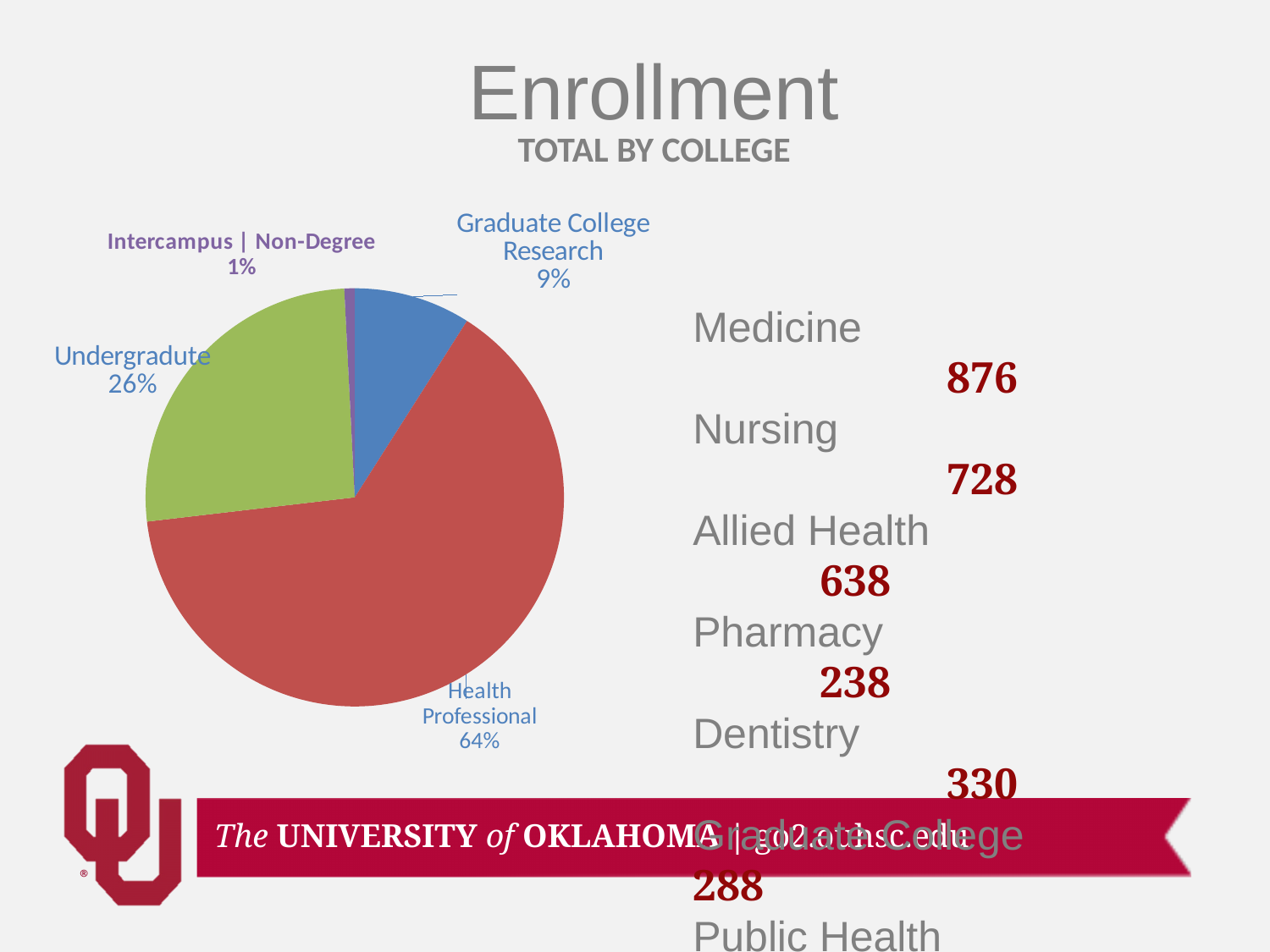
How many slices does the pie chart have? 4 What is the difference in percentage points between the Health Professional and Undergradute slices? 38 What share of the pie does the Graduate College Research slice represent? 9% What kind of chart is shown on the slide? pie chart What is the difference in percentage points between the Graduate College Research and Intercampus | Non-Degree slices? 8 What share of the pie does the Intercampus | Non-Degree slice represent? 1% Which slice of the pie chart is the smallest? Intercampus | Non-Degree What colour is the Health Professional slice of the pie chart? red Which is larger, the Undergradute slice or the Graduate College Research slice? Undergradute Which slice of the pie chart is the largest? Health Professional What share of the pie does the Undergradute slice represent? 26%